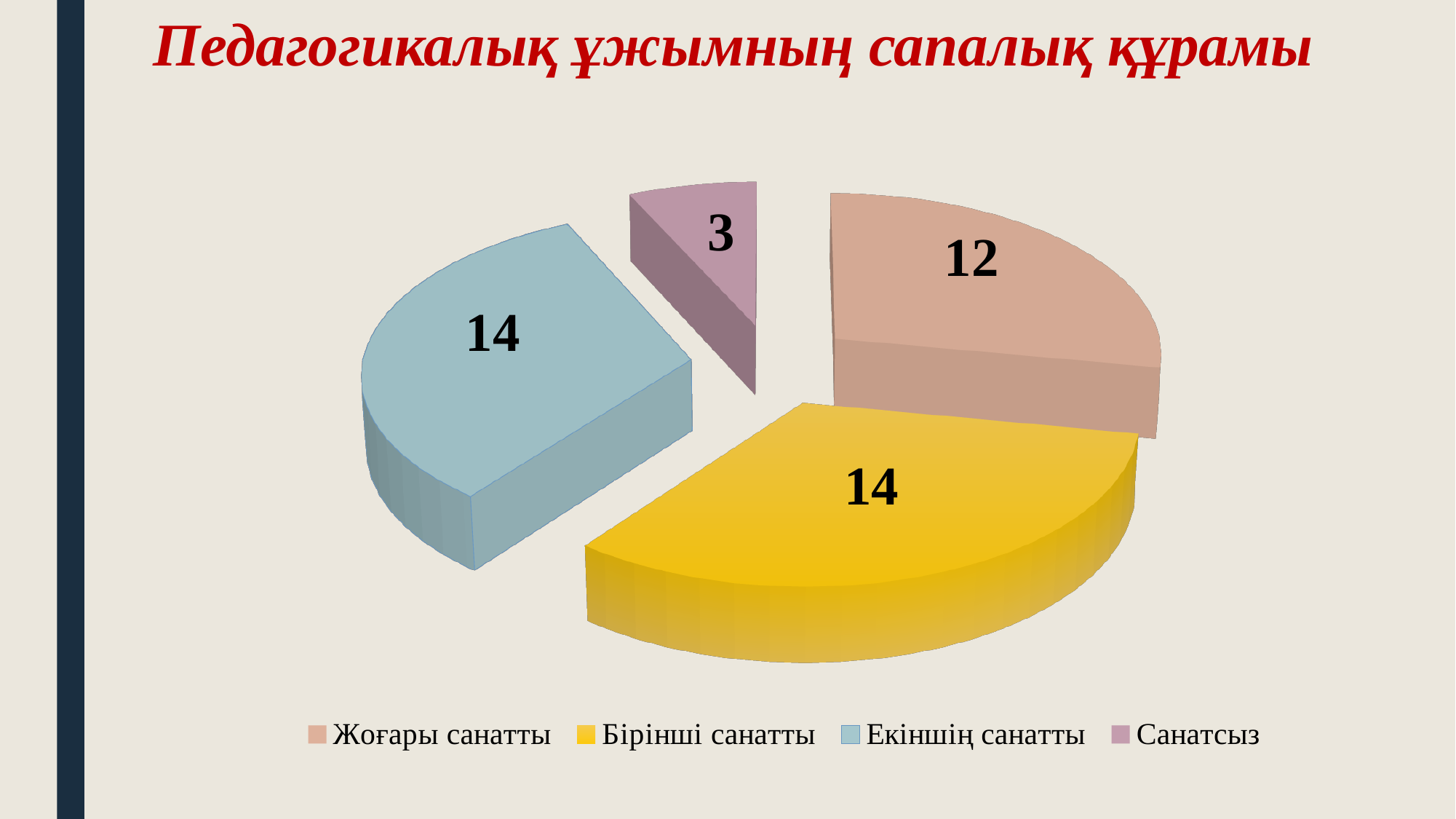
What is the total of all the slice values in the pie chart? 43 What is the value for Жоғары санатты? 12 What is the difference between the values for Бірінші санатты and Жоғары санатты? 2 Which category has the smallest slice? Санатсыз What is the value for Санатсыз? 3 Which is larger, Жоғары санатты or Санатсыз? Жоғары санатты What kind of chart is shown on the slide? pie chart What is the value for Бірінші санатты? 14 What is the value for Екіншің санатты? 14 What is the title of the slide? Педагогикалық ұжымның сапалық құрамы How many slices does the pie chart have? 4 What is the difference between the values for Жоғары санатты and Санатсыз? 9